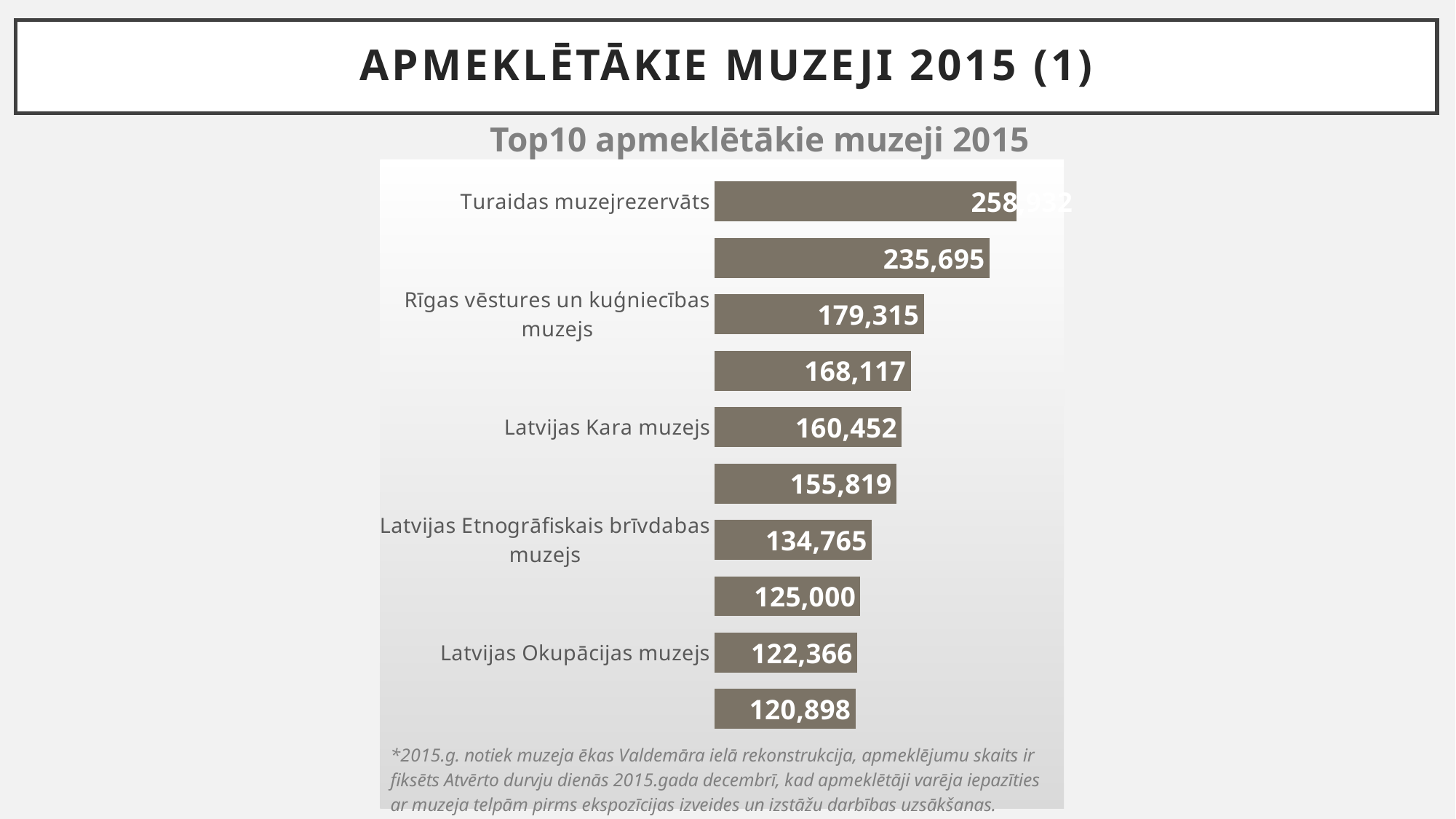
What is the value for Latvijas Etnogrāfiskais brīvdabas muzejs? 134,765 Do the bar values increase or decrease going from the top bar to the bottom bar? Decrease How many bars does the chart contain? 10 Which has a larger value, Latvijas Etnogrāfiskais brīvdabas muzejs or Latvijas Okupācijas muzejs? Latvijas Etnogrāfiskais brīvdabas muzejs Which museum has the highest value in the chart? Turaidas muzejrezervāts What is the value for Latvijas Kara muzejs? 160,452 What is the value for Latvijas Okupācijas muzejs? 122,366 What is the difference between the values for Rīgas vēstures un kuģniecības muzejs and Latvijas Kara muzejs? 18,863 What type of chart is shown on the slide? Bar chart What is the title of the chart? Top10 apmeklētākie muzeji 2015 What is the value of the shortest bar in the chart? 120,898 What is the value for Rīgas vēstures un kuģniecības muzejs? 179,315